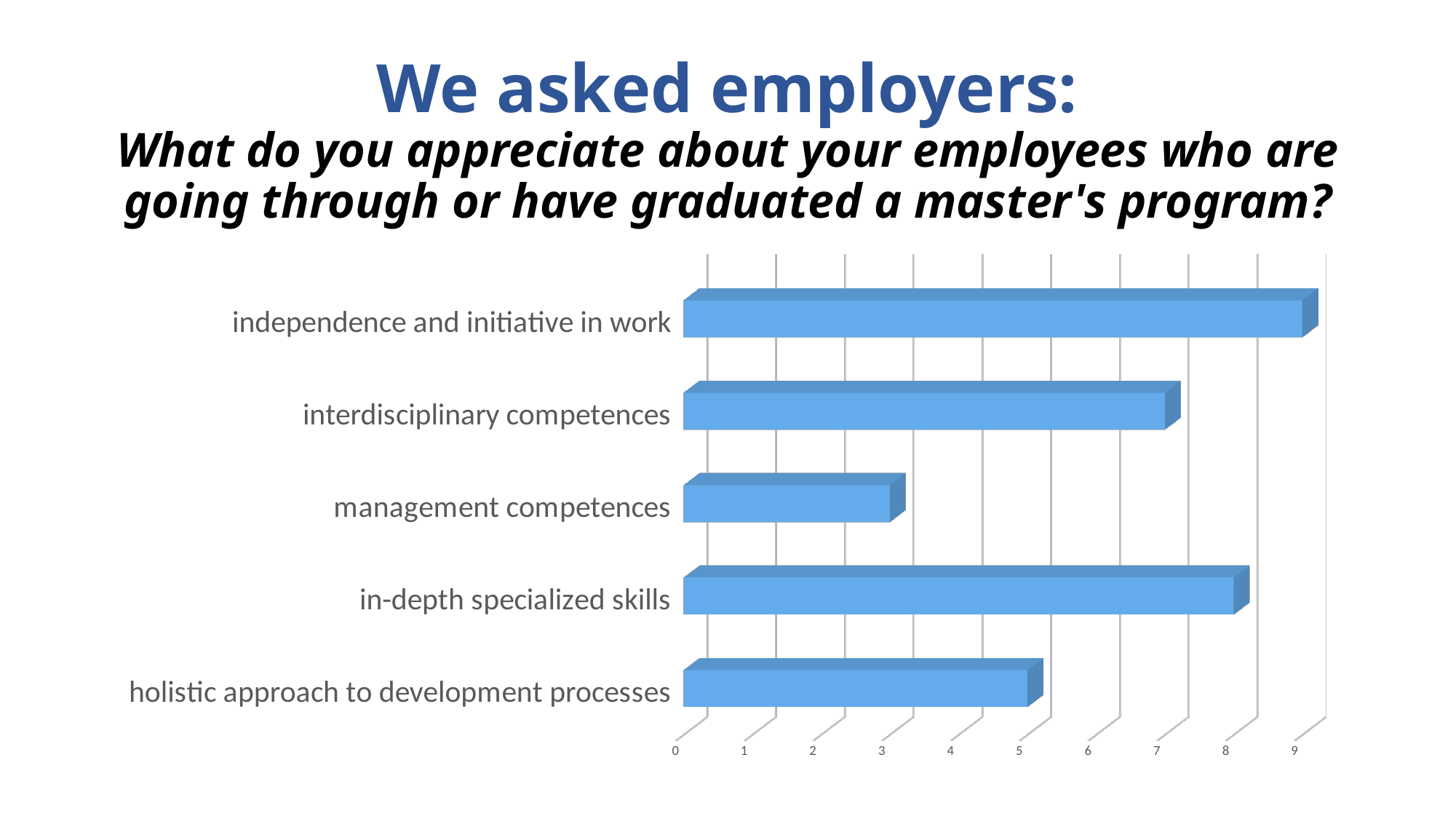
Is the value for holistic approach to development processes greater or less than 4? greater Which is larger, the value for holistic approach to development processes or the value for management competences? holistic approach to development processes Is the value for independence and initiative in work greater or less than 8? greater Is the value for interdisciplinary competences greater or less than 6? greater What kind of chart is shown on the slide? bar chart Which is larger, the value for in-depth specialized skills or the value for interdisciplinary competences? in-depth specialized skills Which category has the lowest value? management competences How many categories are shown in the chart? 5 What colour are the bars in the chart? blue Which category has the highest value? independence and initiative in work